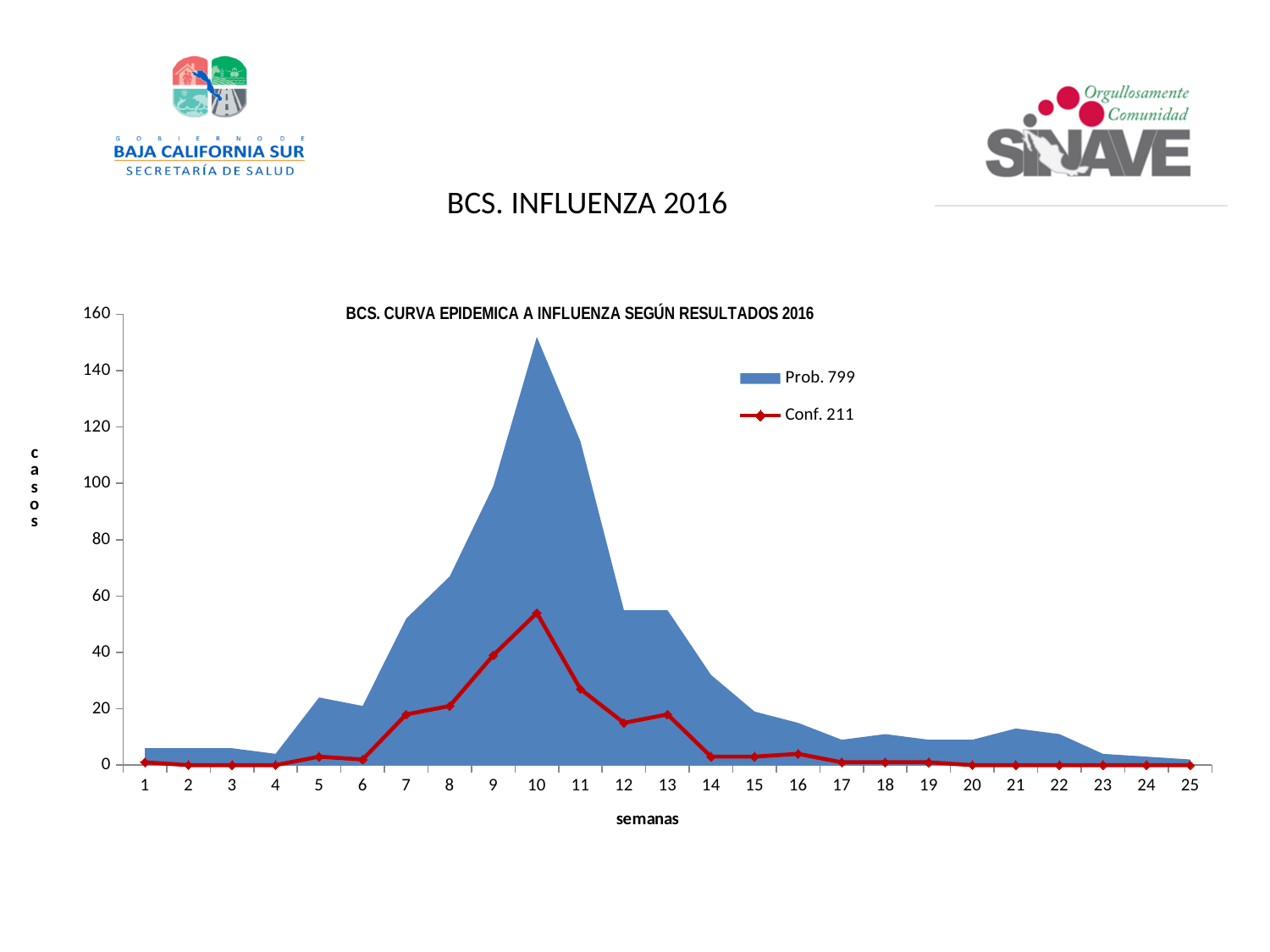
Is the value of Prob. 799 in week 10 greater or less than 140? greater How many series does the legend list? 2 What are the two series named in the legend? Prob. 799 and Conf. 211 In which week does the Conf. 211 line reach its highest value? 10 In which week does the Prob. 799 series reach its highest value? 10 What is the title of the chart? BCS. CURVA EPIDEMICA A INFLUENZA SEGÚN RESULTADOS 2016 Is the value of Conf. 211 in week 10 greater or less than 40? greater Do the Prob. 799 values rise or fall from week 10 to week 14? fall How many weeks are shown on the x axis? 25 Is the value of Prob. 799 in week 12 greater or less than 80? less Which week has a higher Prob. 799 value, week 7 or week 9? week 9